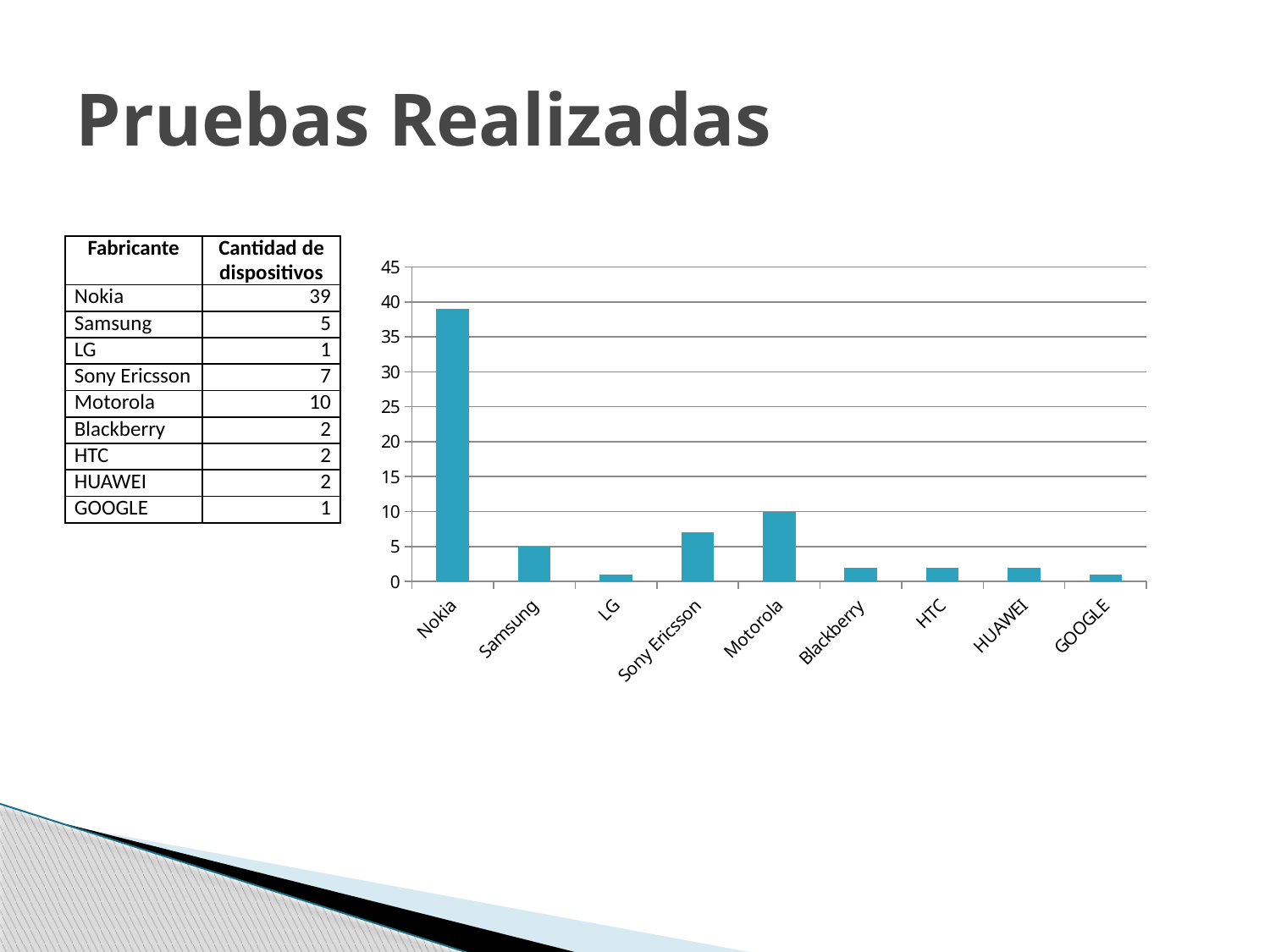
What is the value for Nokia? 39 What is the value for Sony Ericsson? 7 What is the highest value shown on the vertical axis of the chart? 45 Is the value for Blackberry greater or less than 5? less What is the difference between the value for Nokia and the value for Motorola? 29 Is the value for Nokia greater or less than 35? greater What kind of chart is shown on the slide? bar chart What is the value for Samsung? 5 Which manufacturer has the highest number of devices in the chart? Nokia What is the value for Motorola? 10 Which is larger, the value for Motorola or the value for Sony Ericsson? Motorola How many manufacturers (categories) are plotted in the chart? 9